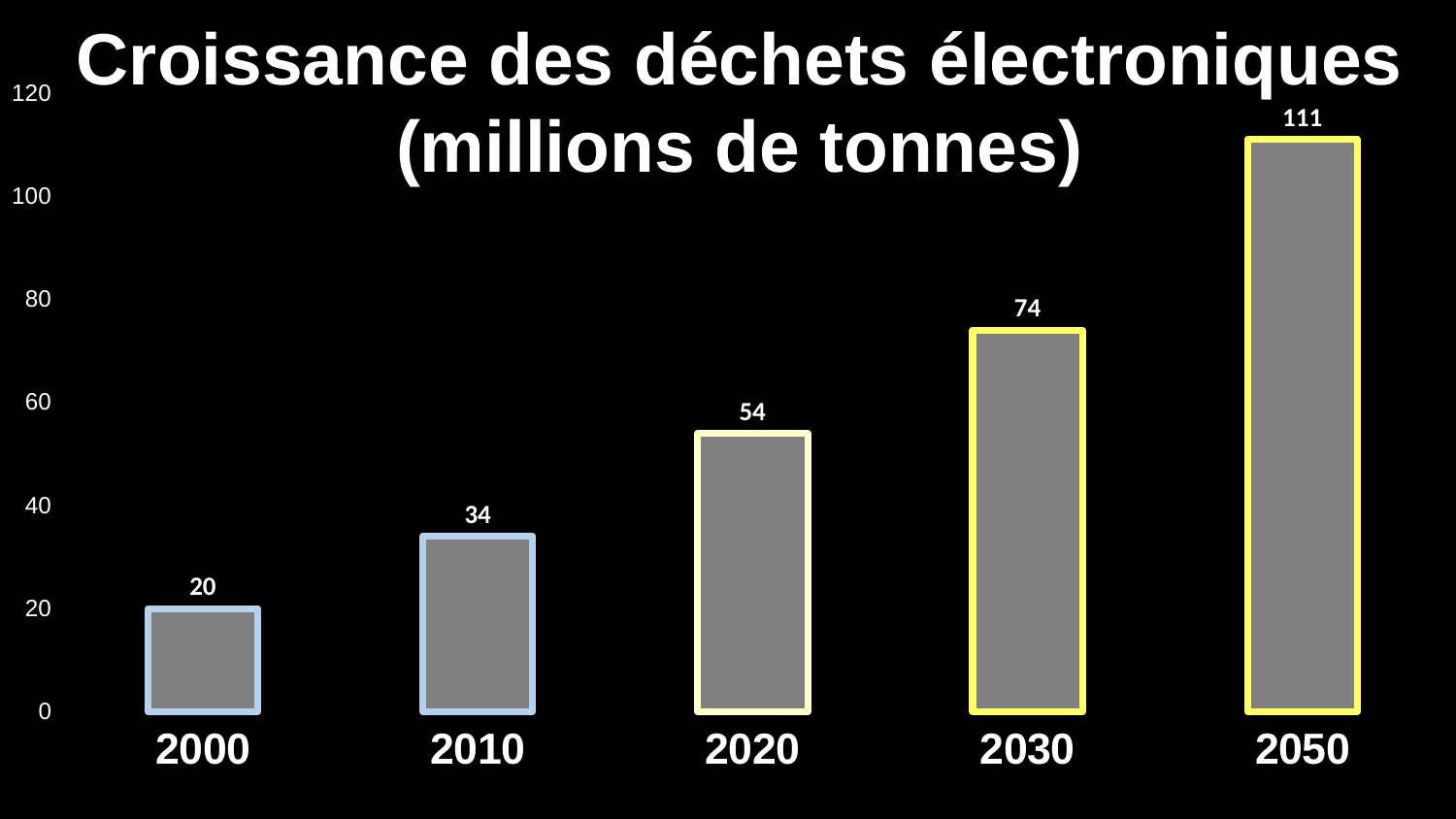
What is the value for 2000? 20 How many years are shown on the x axis? 5 What is the difference between the values for 2050 and 2020? 57 Which year has the lowest value? 2000 What is the value for 2050? 111 What is the value for 2020? 54 What kind of chart is this? bar chart Do the values rise or fall from 2000 to 2050? rise What is the difference between the values for 2030 and 2010? 40 Is the value for 2030 greater or less than 60? greater Which year has the highest value? 2050 Which is larger, the value for 2010 or the value for 2020? 2020